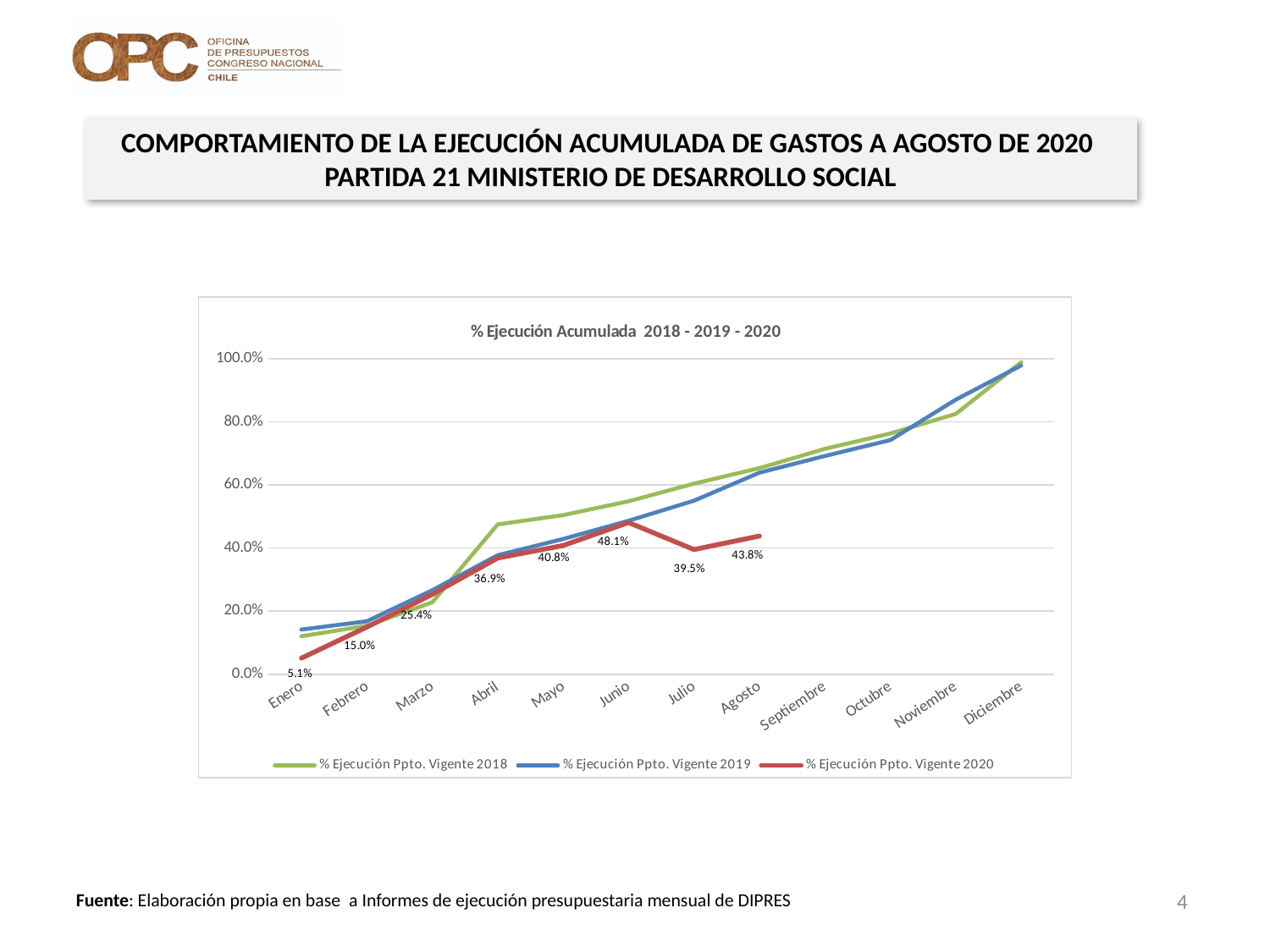
In the % Ejecución Ppto. Vigente 2020 series, which is larger, the value for Abril or the value for Mayo? Mayo Which month has the lowest value in the % Ejecución Ppto. Vigente 2020 series? Enero What is the value for Junio in the % Ejecución Ppto. Vigente 2020 series? 48.1% What is the value for Agosto in the % Ejecución Ppto. Vigente 2020 series? 43.8% How many series does the legend list? 3 What kind of chart is shown on the slide? Line chart What is the title of the chart? % Ejecución Acumulada 2018 - 2019 - 2020 Which month has the highest value in the % Ejecución Ppto. Vigente 2020 series? Junio What is the value for Julio in the % Ejecución Ppto. Vigente 2020 series? 39.5% What is the difference between the Junio and Julio values in the % Ejecución Ppto. Vigente 2020 series? 8.6% What is the value for Enero in the % Ejecución Ppto. Vigente 2020 series? 5.1% Is the value for Diciembre in the % Ejecución Ppto. Vigente 2019 series greater or less than 80.0%? greater